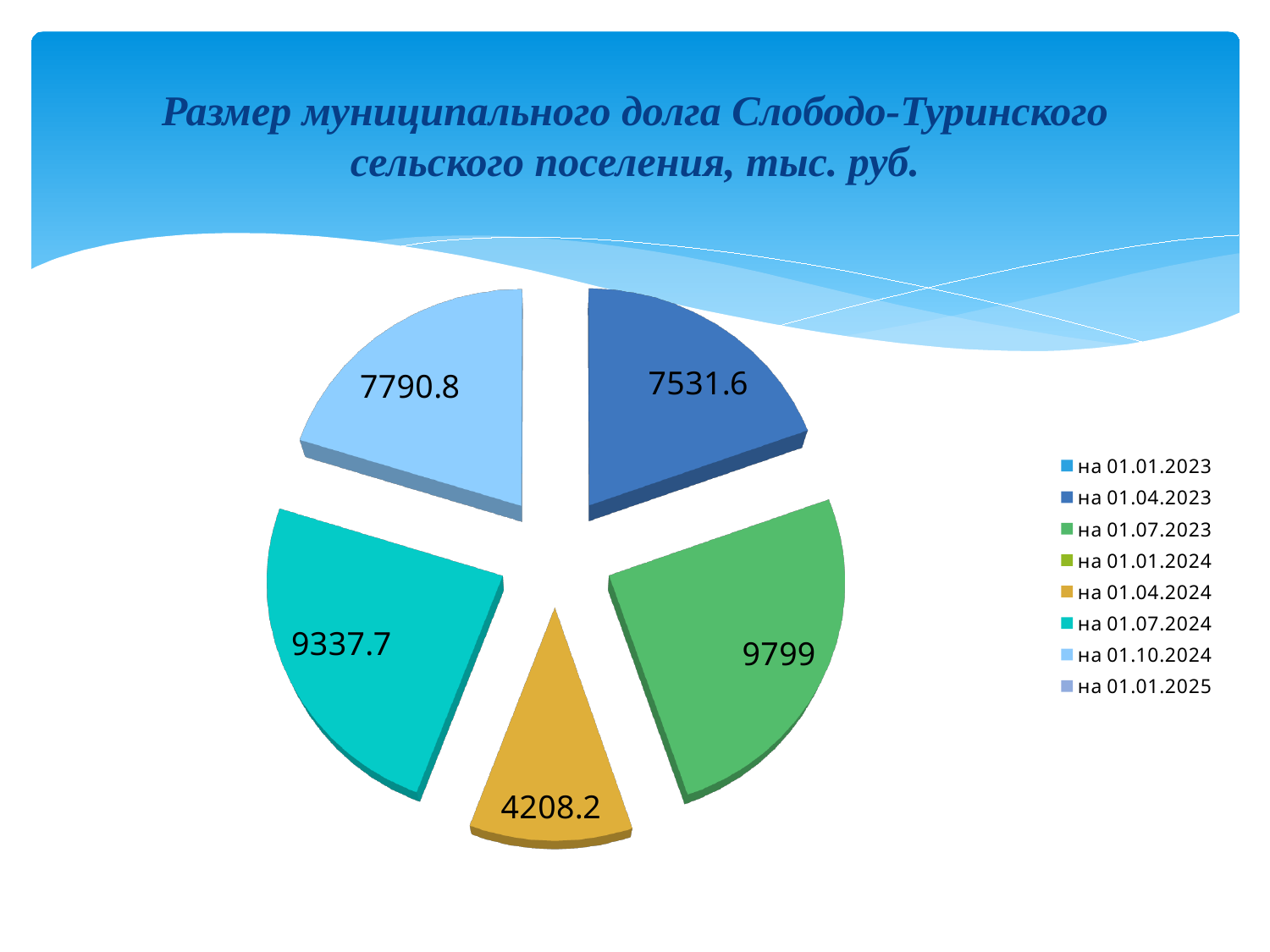
What is the difference between the values 9799 and 9337.7? 461.3 What is the value of the gold slice (на 01.04.2024)? 4208.2 What is the value of the green slice (на 01.07.2023)? 9799 What is the value of the teal slice (на 01.07.2024)? 9337.7 What is the value of the dark blue slice (на 01.04.2023)? 7531.6 Which labelled slice has the largest value? 9799 (на 01.07.2023) What type of chart is shown on the slide? pie chart How many slices with data labels are visible in the pie chart? 5 Which is larger: the value for на 01.10.2024 or the value for на 01.04.2023? на 01.10.2024 (7790.8) Which labelled slice has the smallest value? 4208.2 (на 01.04.2024) How many entries does the legend list? 8 What is the value of the light blue slice (на 01.10.2024)? 7790.8